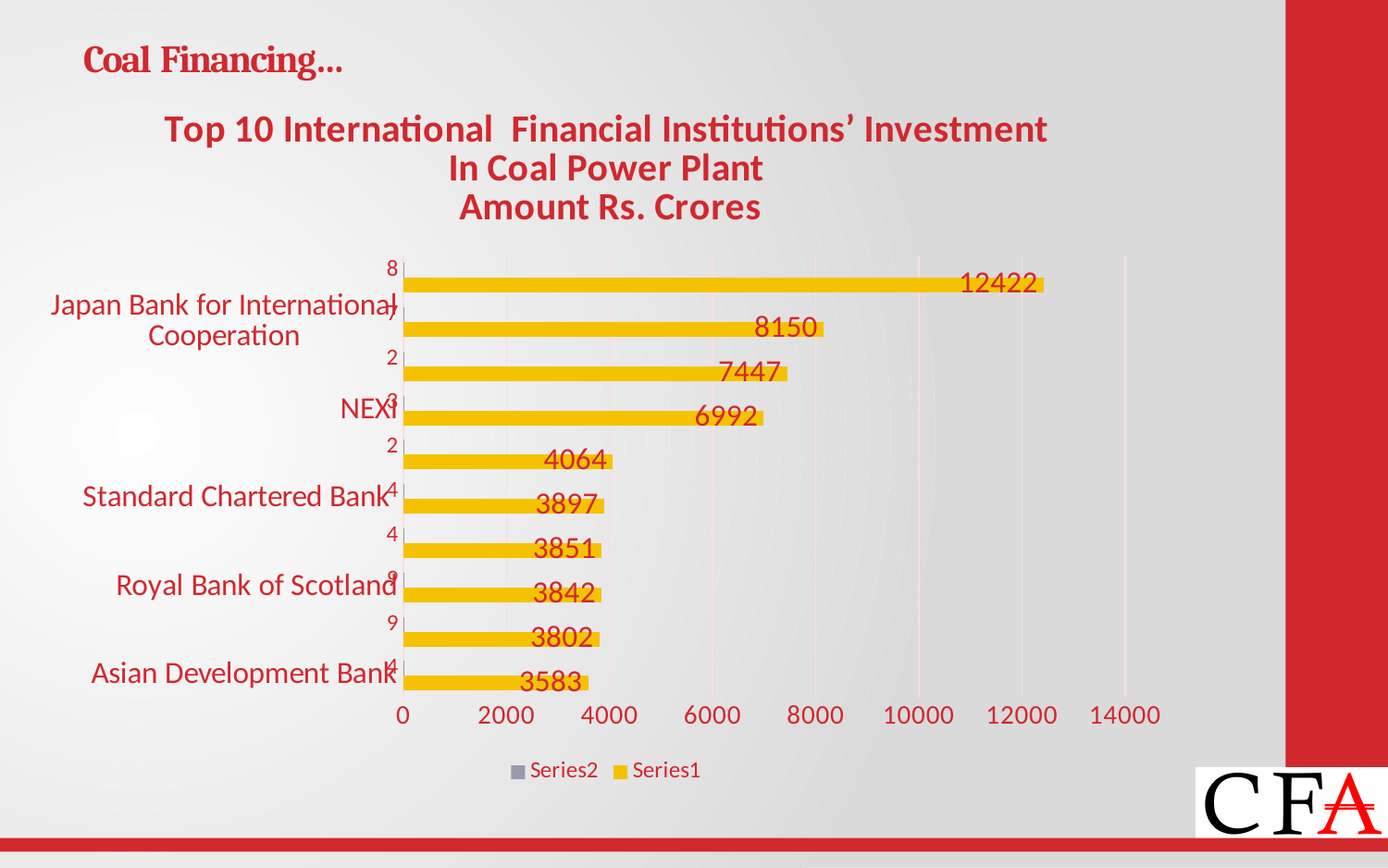
What is the difference between the values for Japan Bank for International Cooperation and NEXI? 1158 Which institution has the lowest investment? Asian Development Bank How many bars are plotted in the chart? 10 Is the value for Japan Bank for International Cooperation greater or less than 12000? less What is the value for Asian Development Bank? 3583 Which is larger, the value for NEXI or the value for Standard Chartered Bank? NEXI What is the value for Royal Bank of Scotland? 3842 What is the value for NEXI? 6992 What is the value for Standard Chartered Bank? 3897 What kind of chart is shown on the slide? bar chart What is the value for Japan Bank for International Cooperation? 8150